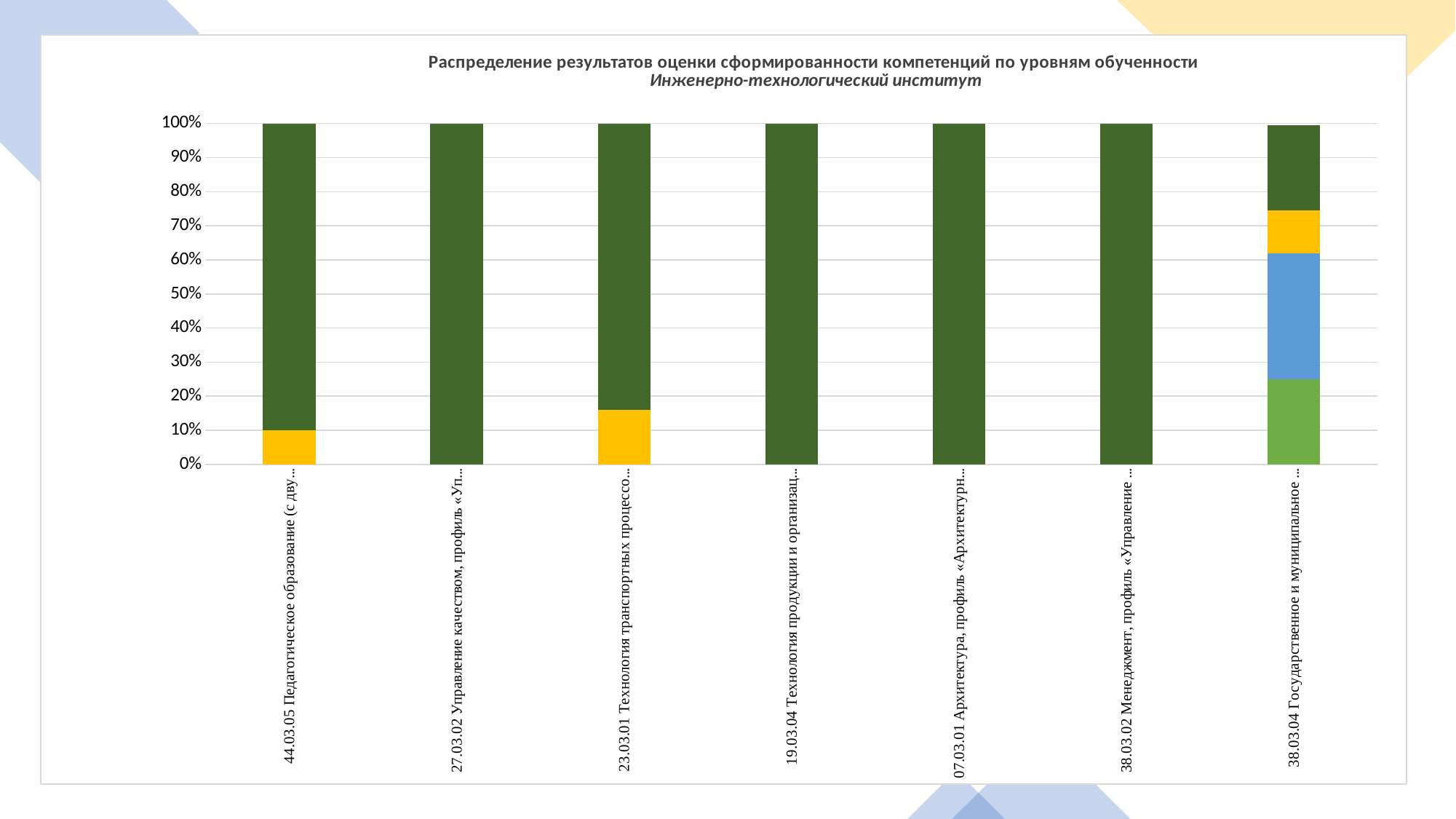
Is the yellow segment for 23.03.01 greater or less than 10%? greater How many categories (programme codes) are shown along the x axis? 7 How many bars consist entirely of the dark green segment? 4 What kind of chart is shown on the slide? Stacked bar chart Which institute is named in the chart subtitle? Инженерно-технологический институт Is the yellow segment for 44.03.05 greater or less than 20%? less Is the yellow segment for 23.03.01 greater or less than 20%? less Which has the larger yellow segment, 44.03.05 or 23.03.01? 23.03.01 Which category's bar is made up of four different coloured segments? 38.03.04 What is the title of the chart? Распределение результатов оценки сформированности компетенций по уровням обученности